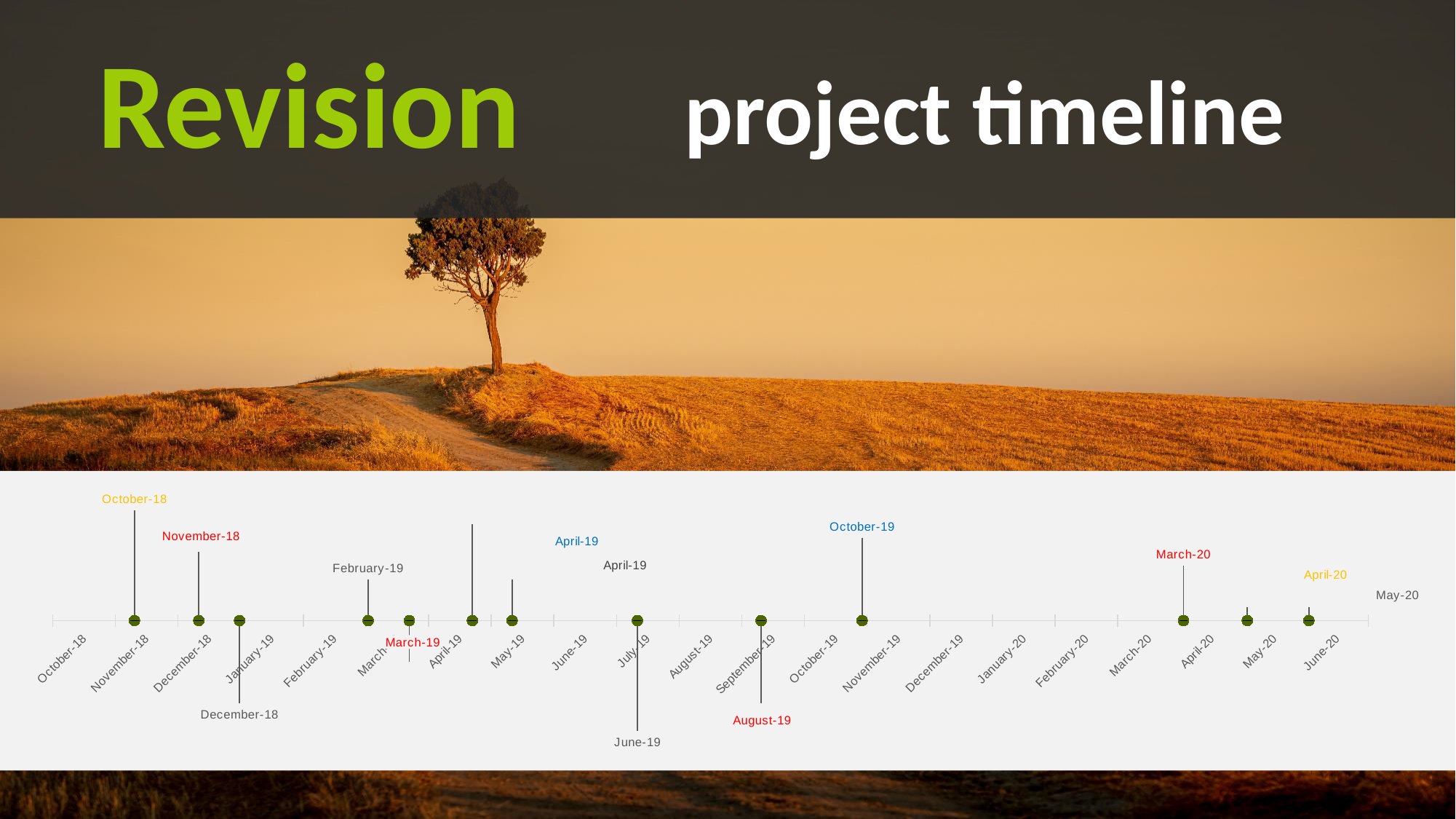
Which milestone label appears twice on the timeline? April-19 How many milestone labels are written in red? 4 What kind of chart is shown on the slide? Timeline chart How many month labels are shown along the timeline axis? 21 What colour is the October-19 milestone label? Blue How many milestone markers are plotted on the timeline? 13 What is the label of the last (rightmost) milestone on the timeline? May-20 What is the last month label on the timeline axis? June-20 How many milestone labels are placed below the timeline axis? 4 What is the label of the first (leftmost) milestone on the timeline? October-18 What is the first month label on the timeline axis? October-18